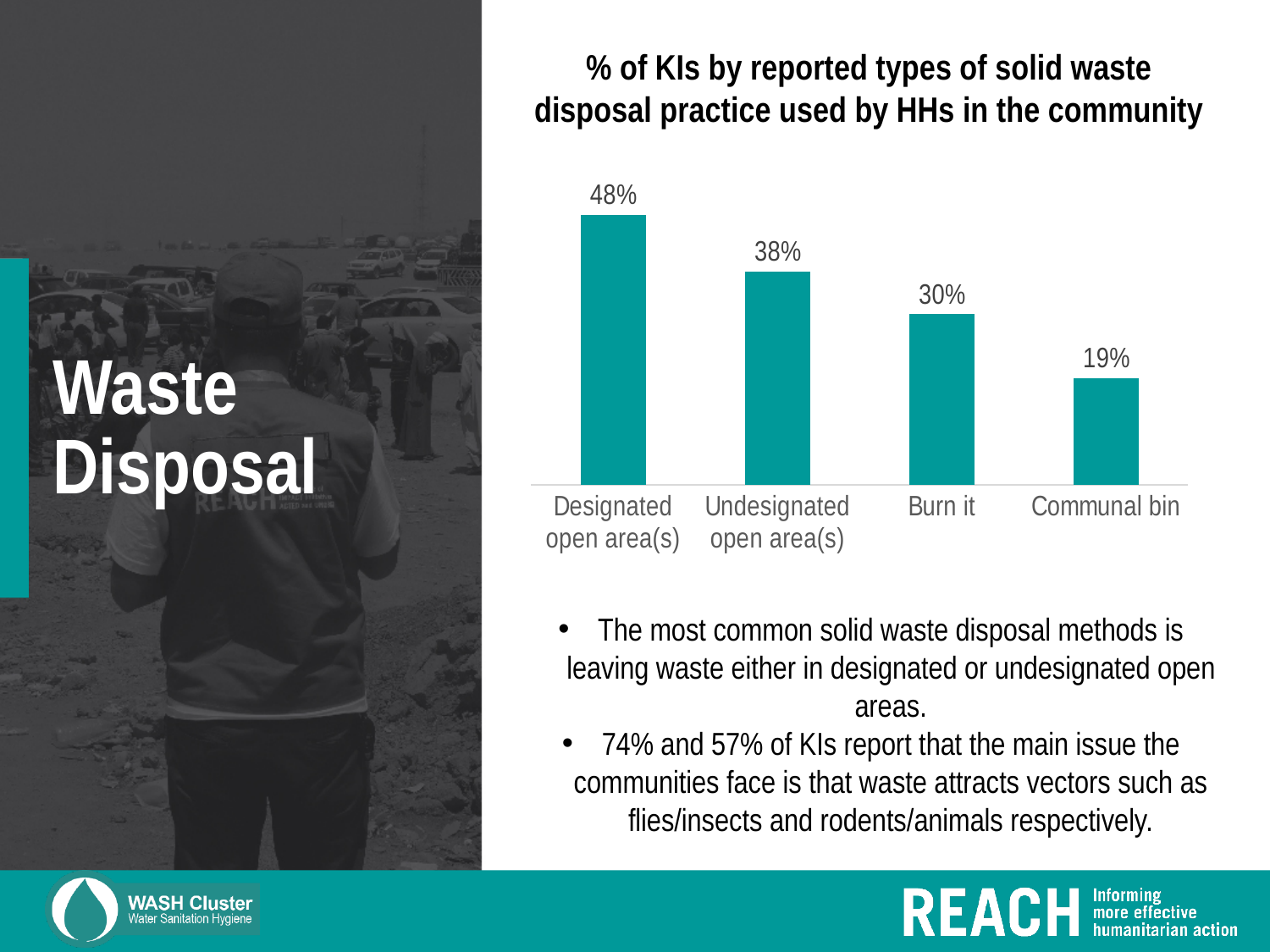
What type of chart is shown on the slide? Bar chart How many disposal practice categories are shown in the chart? 4 What is the value shown for Undesignated open area(s)? 38% Do the values rise or fall from left to right across the categories? Fall Which is larger, the value for Burn it or the value for Communal bin? Burn it What is the value for Communal bin? 19% Which solid waste disposal practice has the lowest percentage of KIs? Communal bin What is the difference in percentage points between Designated open area(s) and Communal bin? 29 Which solid waste disposal practice has the highest percentage of KIs? Designated open area(s) What percentage of KIs reported 'Burn it'? 30% What is the difference between the values for Undesignated open area(s) and Burn it? 8 What percentage of KIs reported designated open area(s) as a solid waste disposal practice? 48%